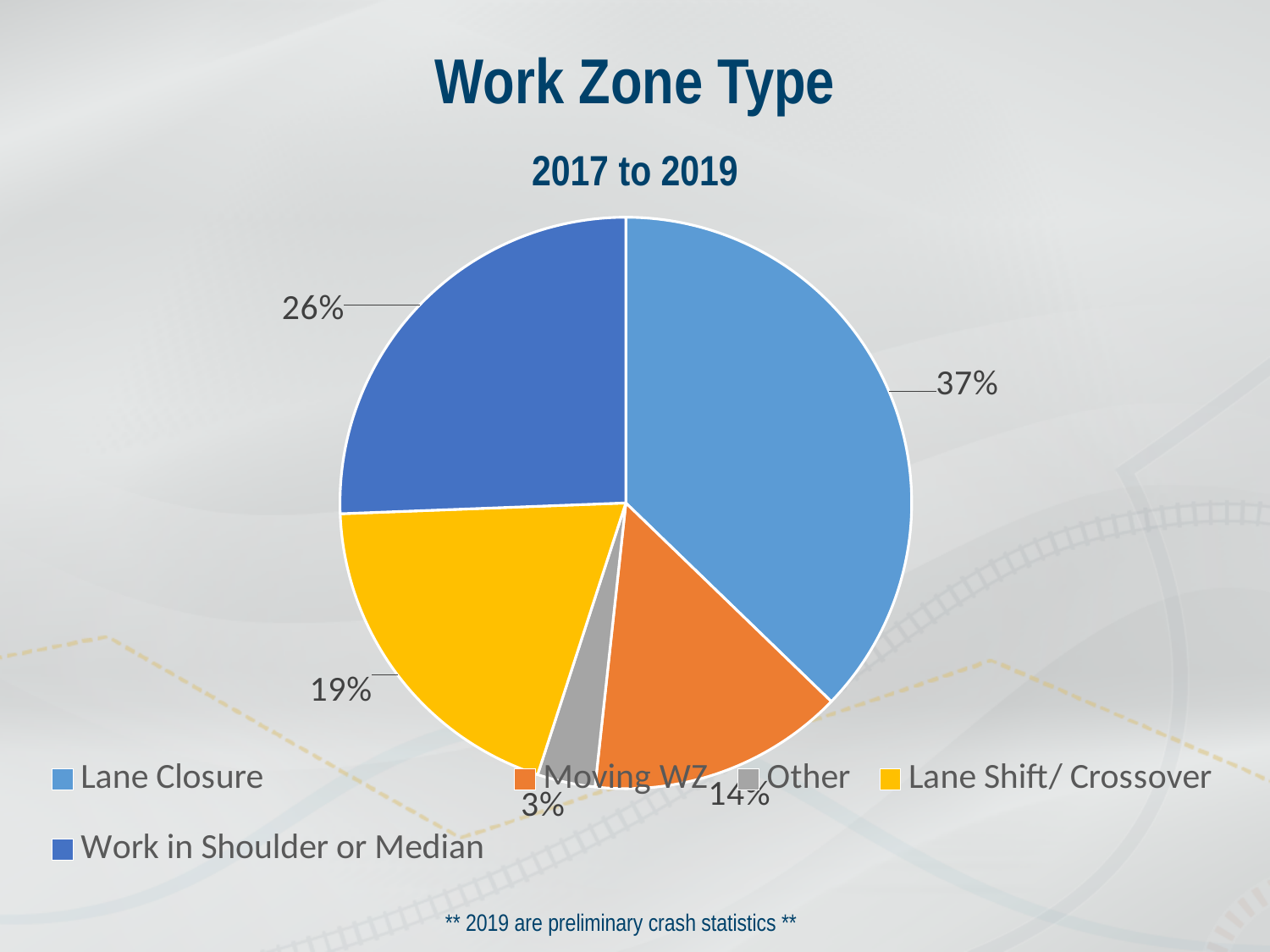
What share of the pie does Other represent? 3% What is the difference in percentage points between Lane Closure and Work in Shoulder or Median? 11 How many categories does the legend list? 5 What share of the pie does Moving WZ represent? 14% Which work zone type has the largest slice of the pie? Lane Closure What share of the pie does Work in Shoulder or Median represent? 26% Which is larger, the share for Moving WZ or the share for Lane Shift/ Crossover? Lane Shift/ Crossover Which work zone type has the smallest slice of the pie? Other What kind of chart is shown on the slide? Pie chart What is the title shown directly above the pie chart? 2017 to 2019